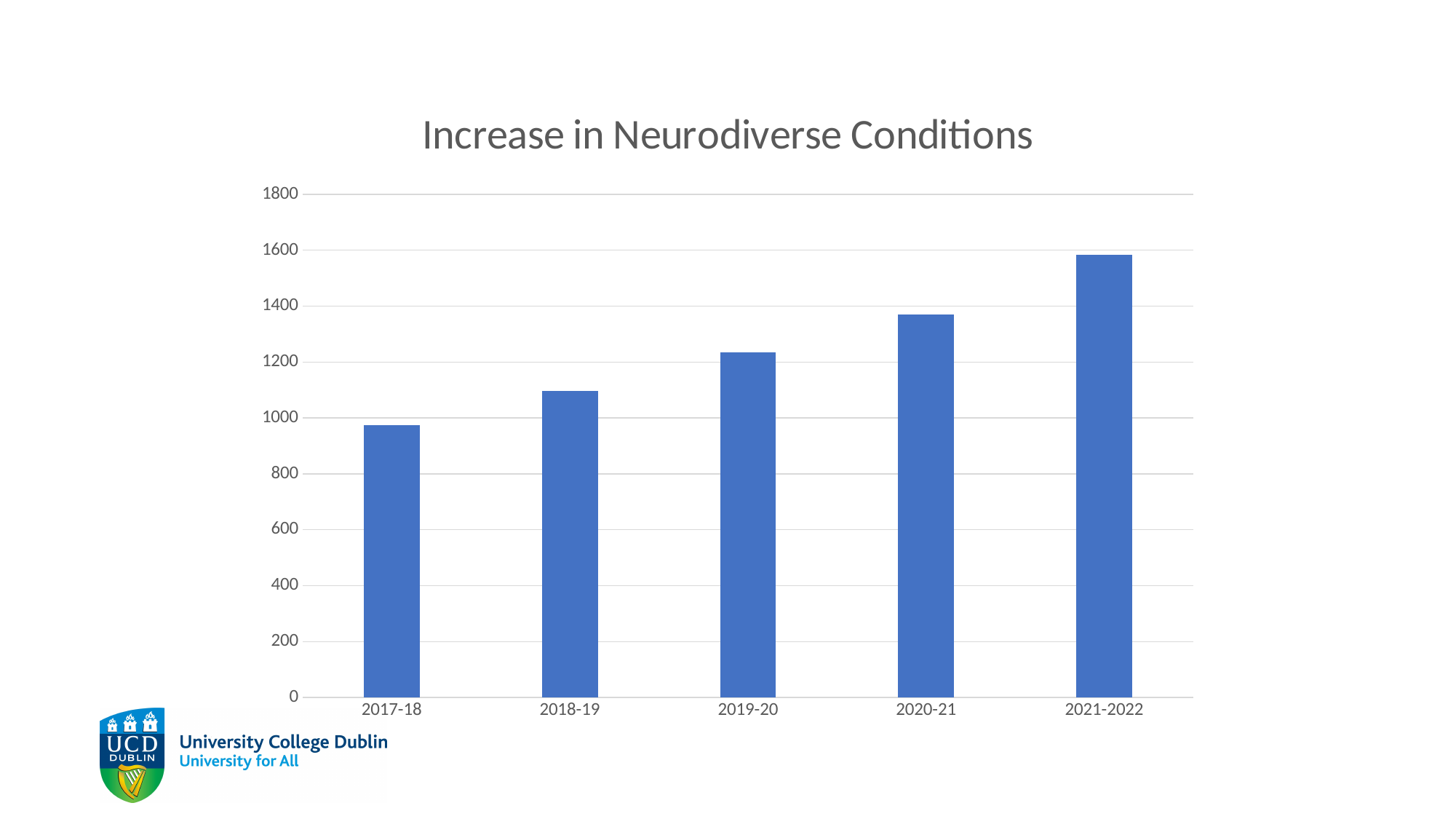
Which year has the highest value? 2021-2022 What kind of chart is shown on the slide? bar chart Is the value for 2017-18 greater or less than 1000? less Which year has the lowest value? 2017-18 Do the values rise or fall from 2017-18 to 2021-2022? rise Is the value for 2018-19 greater or less than 1000? greater What is the title of the chart? Increase in Neurodiverse Conditions Which is larger, the value for 2019-20 or the value for 2020-21? 2020-21 Is the value for 2020-21 greater or less than 1400? less How many categories are shown on the x axis? 5